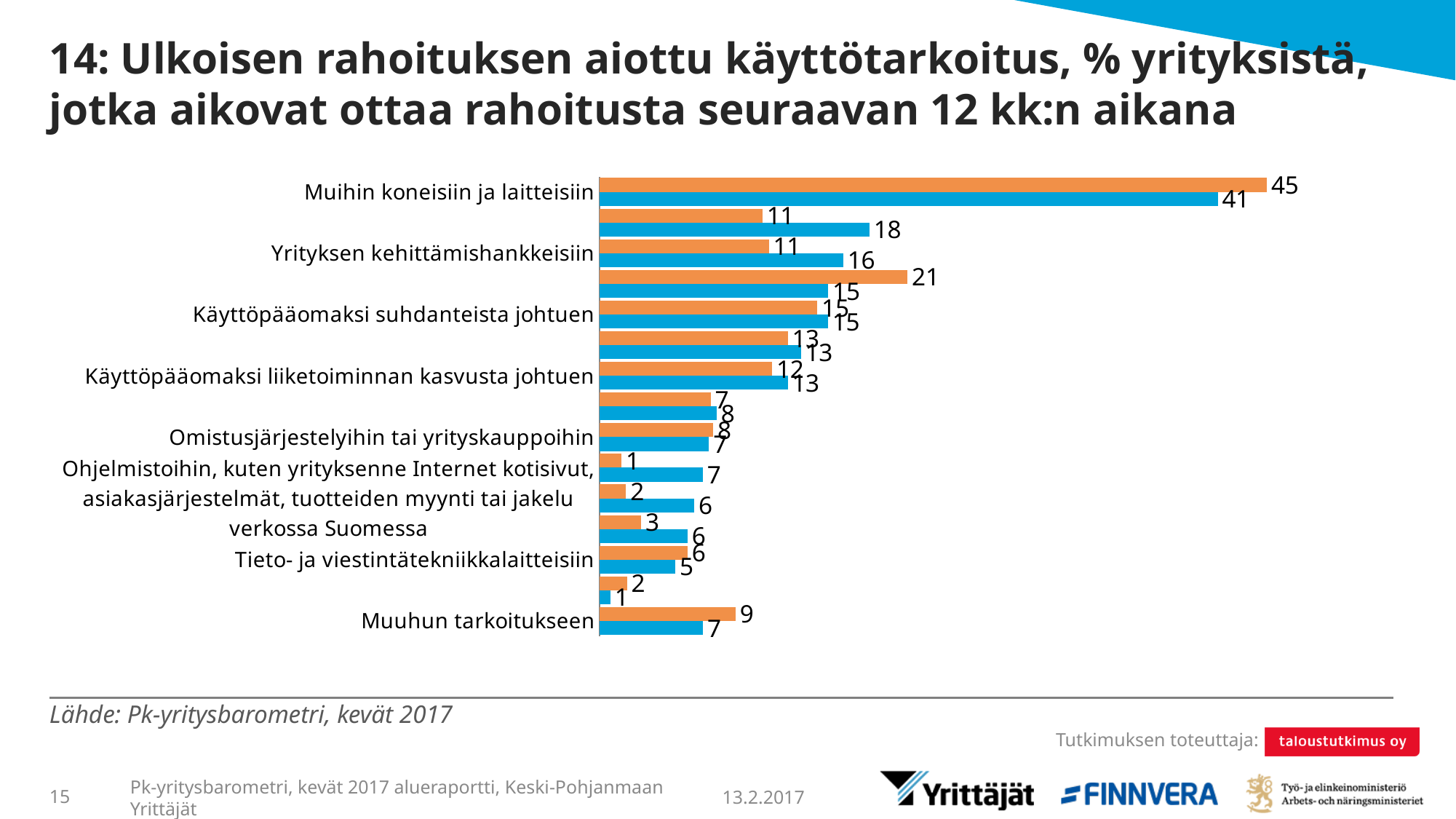
What is the value of the blue bar for "Muihin koneisiin ja laitteisiin"? 41 What is the difference between the orange and blue values for "Muihin koneisiin ja laitteisiin"? 4 What is the value of the blue bar for "Yrityksen kehittämishankkeisiin"? 16 What type of chart is shown on the slide? bar chart What is the value of the orange bar for "Muihin koneisiin ja laitteisiin"? 45 For "Yrityksen kehittämishankkeisiin", which is larger, the orange bar or the blue bar? the blue bar How many bars are shown for each category? 2 What is the value of the orange bar for "Käyttöpääomaksi suhdanteista johtuen"? 15 What is the source cited below the chart? Pk-yritysbarometri, kevät 2017 Which category has the highest orange bar value? Muihin koneisiin ja laitteisiin What is the value of the orange bar for "Muuhun tarkoitukseen"? 9 What is the difference between the blue and orange values for "Yrityksen kehittämishankkeisiin"? 5